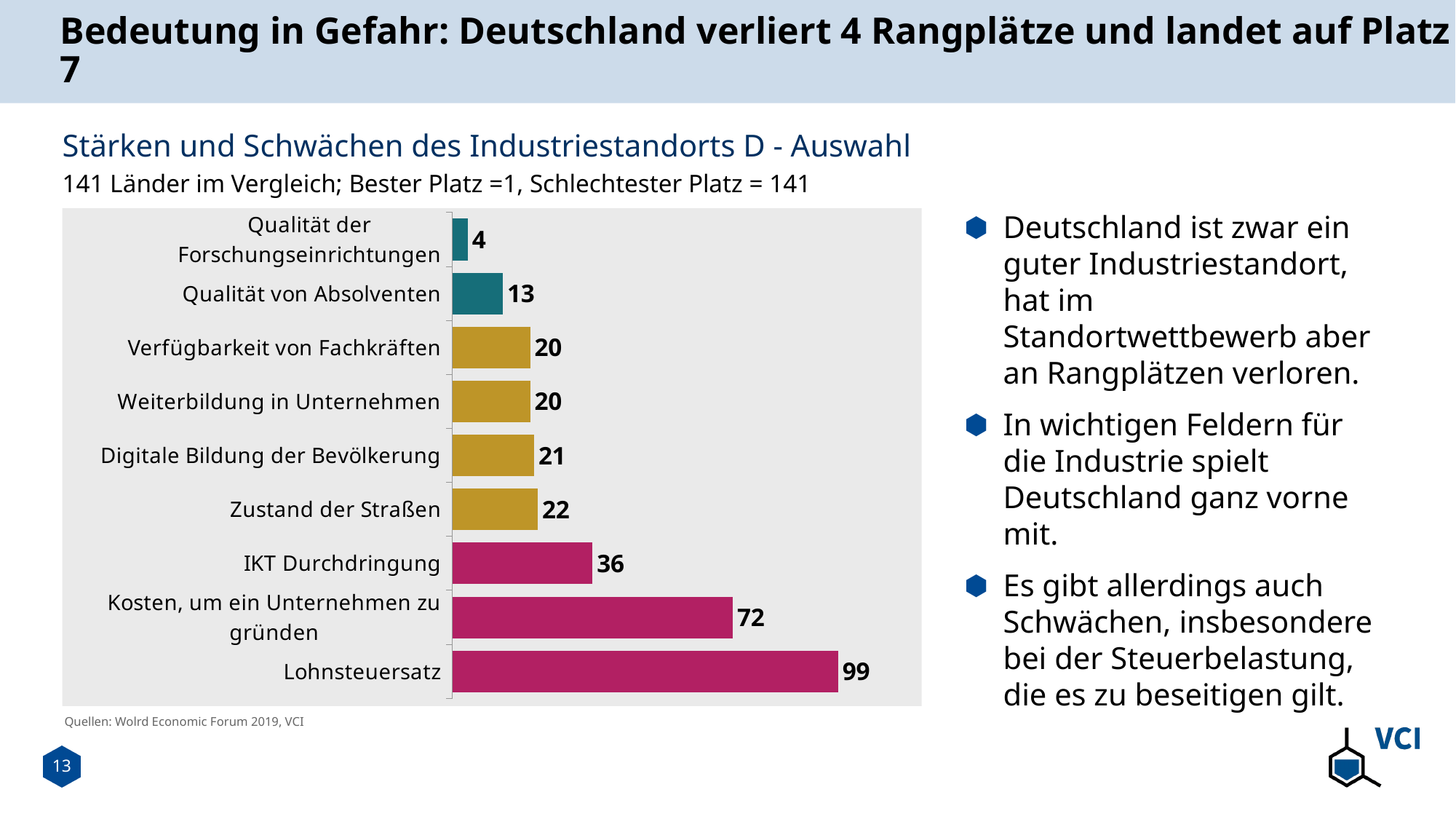
Which has the larger value, Digitale Bildung der Bevölkerung or Qualität von Absolventen? Digitale Bildung der Bevölkerung What type of chart is shown on the slide? bar chart How many categories are shown in the chart? 9 What rank is shown for Lohnsteuersatz? 99 What value is shown for Qualität von Absolventen? 13 Which category has the lowest value in the chart? Qualität der Forschungseinrichtungen Which category has the highest value in the chart? Lohnsteuersatz What is the difference between the values for Lohnsteuersatz and Kosten, um ein Unternehmen zu gründen? 27 What is the difference between the values for IKT Durchdringung and Zustand der Straßen? 14 What value is shown for IKT Durchdringung? 36 Which two categories share the value 20? Verfügbarkeit von Fachkräften and Weiterbildung in Unternehmen What is the title of the chart? Stärken und Schwächen des Industriestandorts D - Auswahl